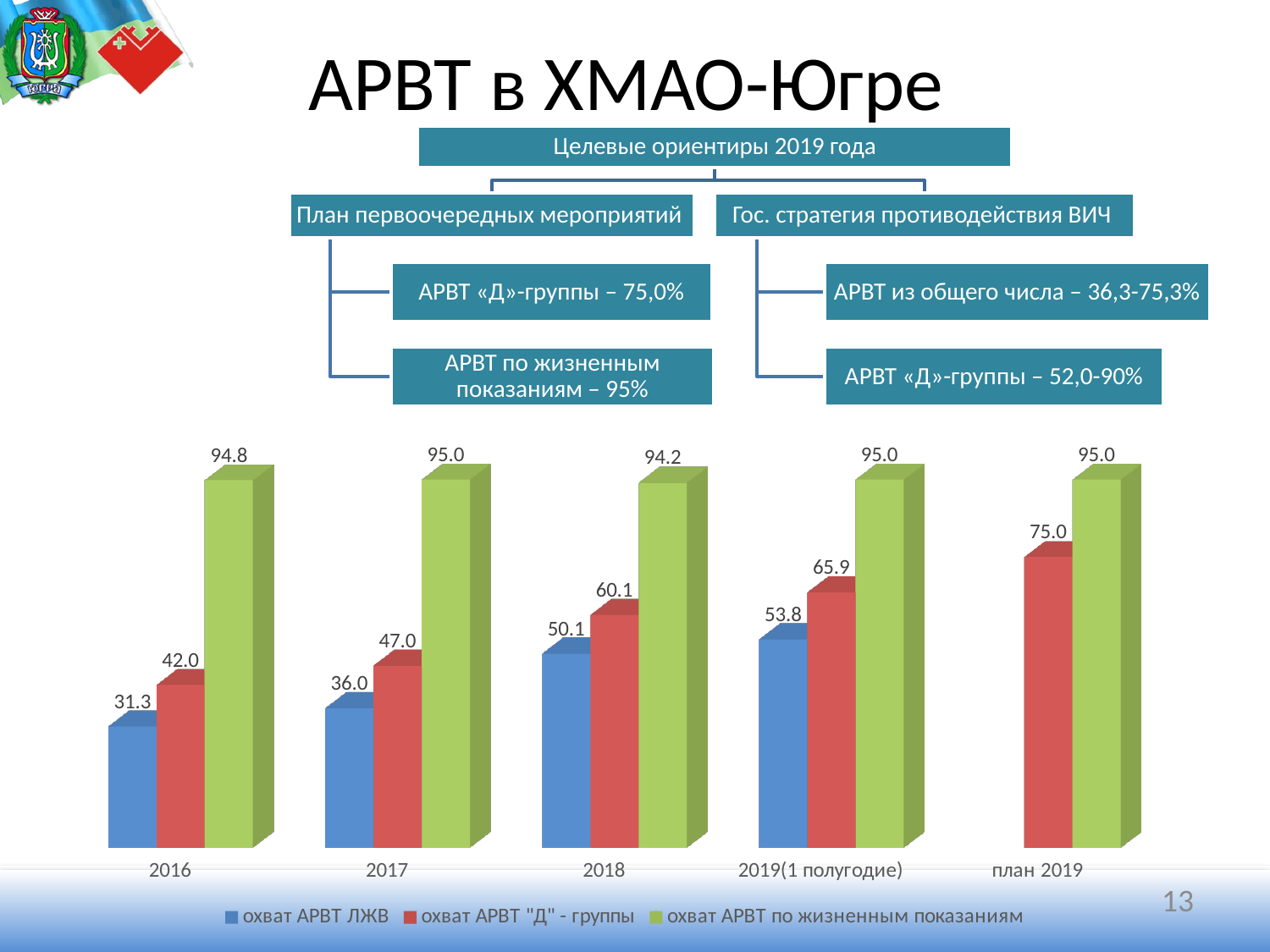
What kind of chart is shown on the slide? bar chart Which is larger in 2017: охват АРВТ ЛЖВ or охват АРВТ "Д" - группы? охват АРВТ "Д" - группы How many series does the chart legend list? 3 What is the value for охват АРВТ ЛЖВ in 2016? 31.3 Does охват АРВТ "Д" - группы rise or fall from 2016 to план 2019? rise What is the difference between охват АРВТ "Д" - группы and охват АРВТ ЛЖВ in 2019(1 полугодие)? 12.1 What is the value for охват АРВТ "Д" - группы in план 2019? 75.0 In which category is охват АРВТ по жизненным показаниям the lowest? 2018 How many categories are shown on the x axis of the chart? 5 In which category is охват АРВТ ЛЖВ the highest? 2019(1 полугодие) What is the value for охват АРВТ по жизненным показаниям in 2017? 95.0 What is the value for охват АРВТ "Д" - группы in 2018? 60.1